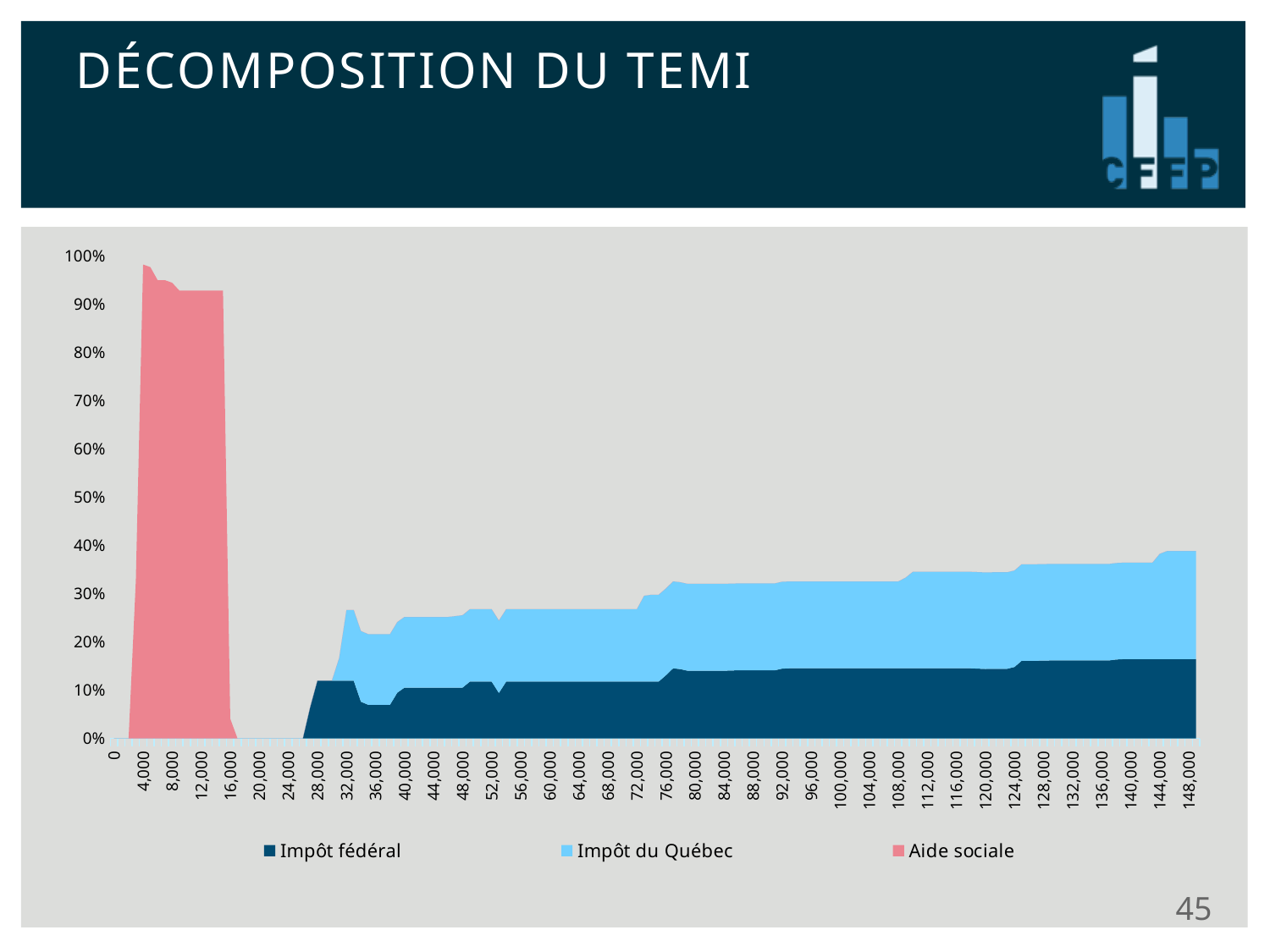
Is the value for Aide sociale at an income of 8,000 greater or less than 90%? greater Does the Impôt fédéral value generally rise or fall between incomes of 80,000 and 148,000? rise What is the title of the slide containing the chart? DÉCOMPOSITION DU TEMI What is the highest value shown on the vertical axis? 100% What kind of chart is shown on the slide? Stacked area chart Is the combined stacked value at an income of 148,000 greater or less than 30%? greater Which series has the highest value at an income of 12,000? Aide sociale Is the value for Aide sociale at an income of 40,000 greater or less than 10%? less How many series does the legend list? 3 What are the three series named in the legend? Impôt fédéral, Impôt du Québec, Aide sociale